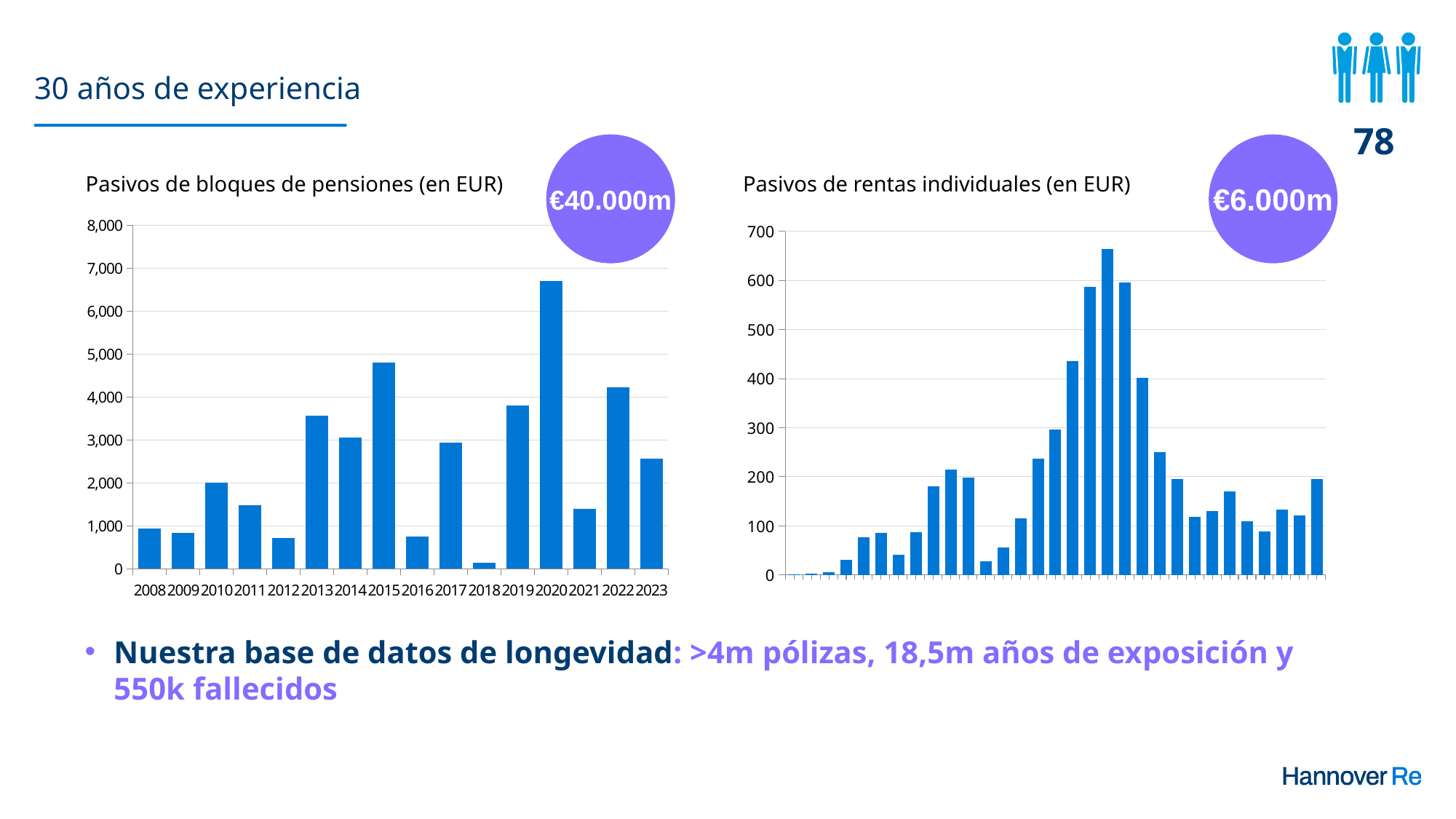
In the chart 'Pasivos de rentas individuales (en EUR)', is the tallest bar greater or less than 600? greater In the chart 'Pasivos de bloques de pensiones (en EUR)', which year has the larger value, 2014 or 2015? 2015 In the chart 'Pasivos de bloques de pensiones (en EUR)', which year has the highest value? 2020 In the chart 'Pasivos de bloques de pensiones (en EUR)', which year has the larger value, 2010 or 2011? 2010 In the chart 'Pasivos de bloques de pensiones (en EUR)', is the value for 2020 greater or less than 6,000? greater In the chart 'Pasivos de bloques de pensiones (en EUR)', is the value for 2015 greater or less than 4,000? greater What type of chart is 'Pasivos de bloques de pensiones (en EUR)'? bar chart What total figure is shown in the purple circle next to the chart 'Pasivos de rentas individuales (en EUR)'? €6.000m In the chart 'Pasivos de bloques de pensiones (en EUR)', which year has the lowest value? 2018 In the chart 'Pasivos de bloques de pensiones (en EUR)', how many years are shown on the x axis? 16